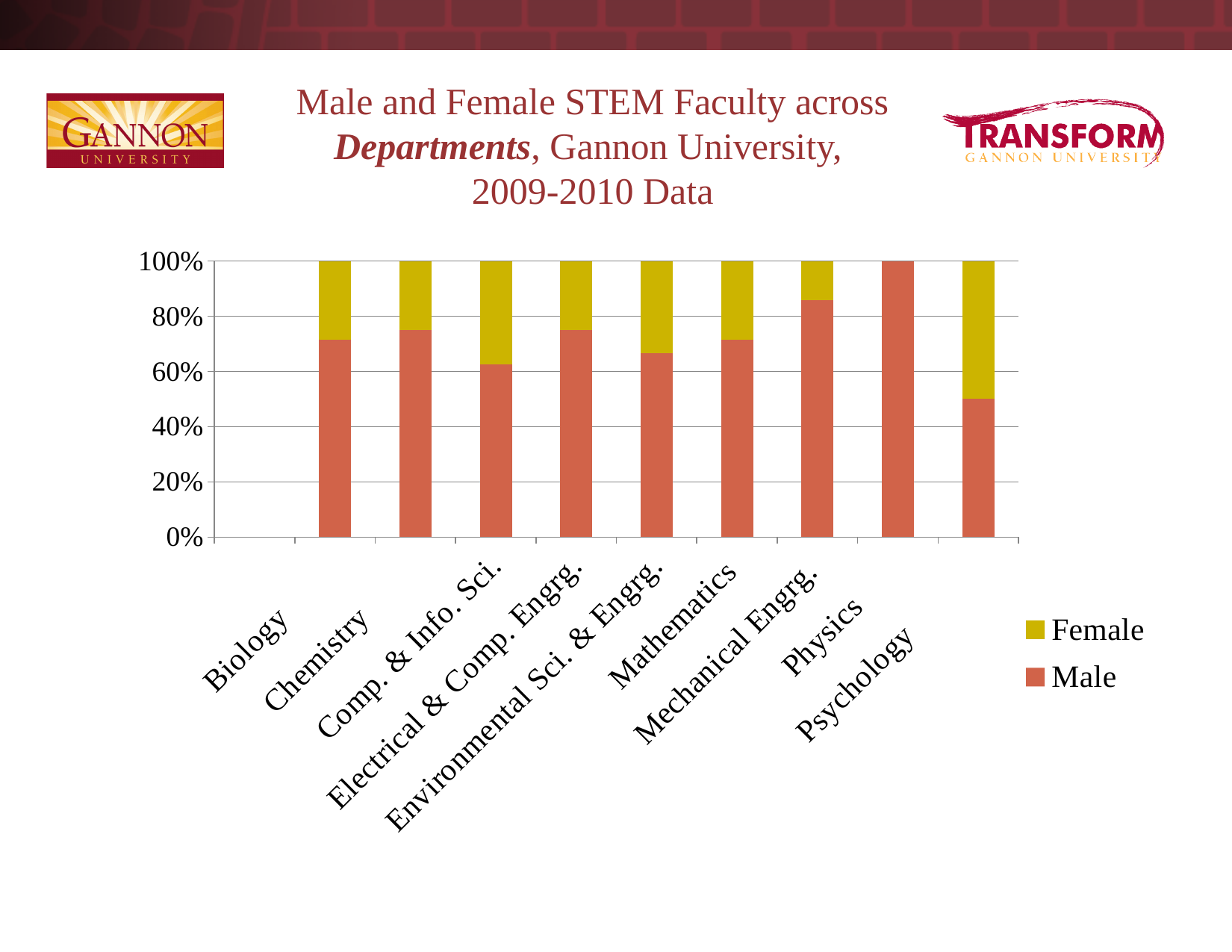
Which colour represents Female faculty in the chart? Yellow Is the male share of faculty in Biology greater or less than 80%? less Is the male share of faculty in Psychology greater or less than 60%? less What kind of chart is shown on the slide? Stacked bar chart Is the male share of faculty in Mechanical Engrg. greater or less than 80%? greater How many departments are shown on the x axis of the chart? 9 Which department has the lowest share of male faculty? Psychology Which department has a larger male share of faculty, Chemistry or Comp. & Info. Sci.? Chemistry Which department has the highest share of male faculty? Physics Which department has the highest share of female faculty? Psychology What is the male share of faculty in Physics? 100% How many series does the chart legend list? 2